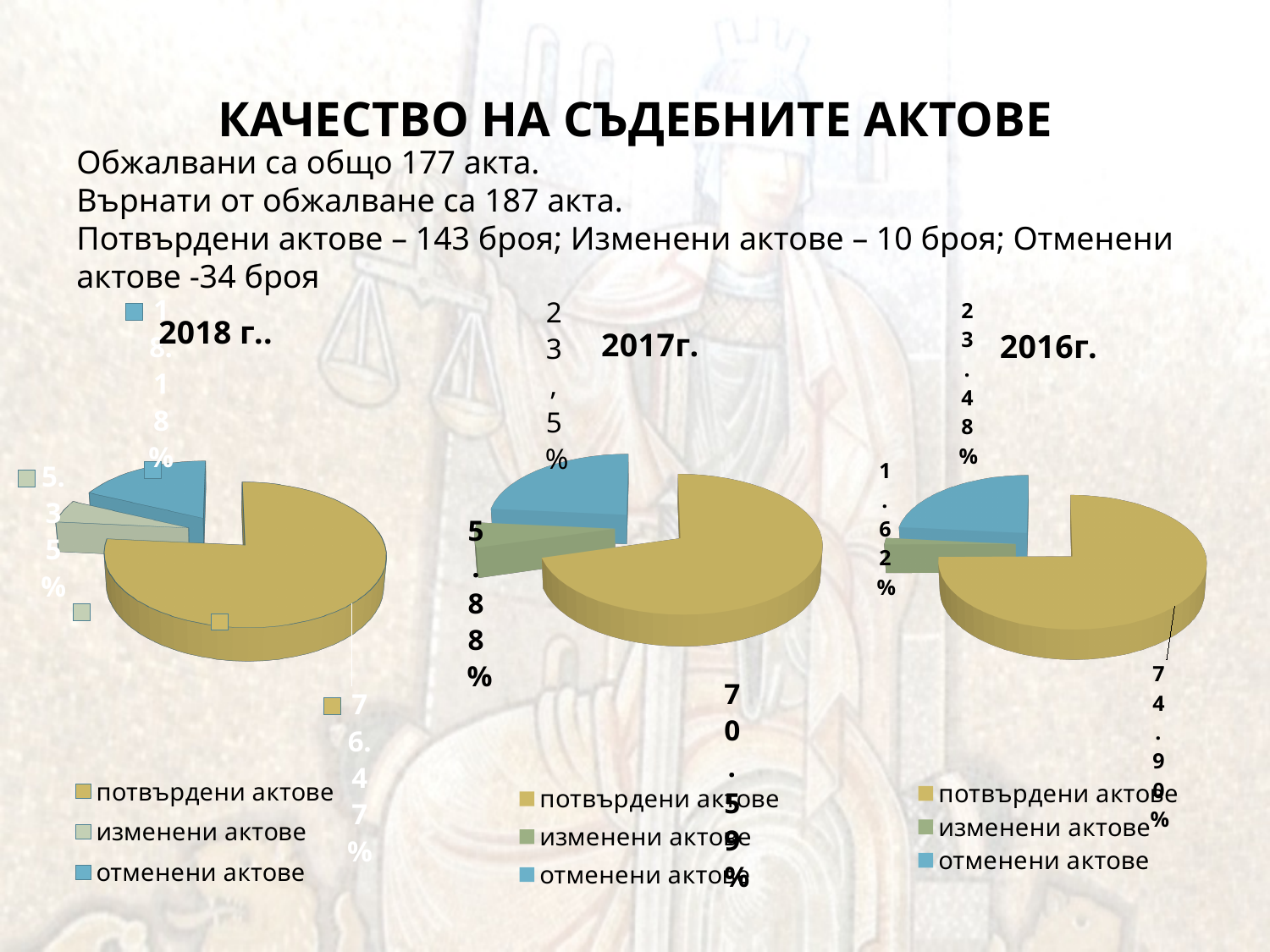
What kind of chart is the 2018 г.. chart? pie chart In the 2018 г.. chart, what is the value for изменени актове? 5.35% In the 2016г. chart, which category has the largest slice? потвърдени актове In the 2016г. chart, what is the difference between отменени актове and изменени актове? 21.86% In the 2017г. chart, what is the value for отменени актове? 23,5% In the 2017г. chart, what is the value for потвърдени актове? 70.59% In the 2017г. chart, which category has the smallest slice? изменени актове In the 2017г. chart, what is the value for изменени актове? 5.88% In the 2016г. chart, what is the value for изменени актове? 1.62% In the 2018 г.. chart, what is the value for потвърдени актове? 76.47% In the 2016г. chart, what is the value for отменени актове? 23.48% Which is larger: потвърдени актове in the 2016г. chart or in the 2017г. chart? 2016г.